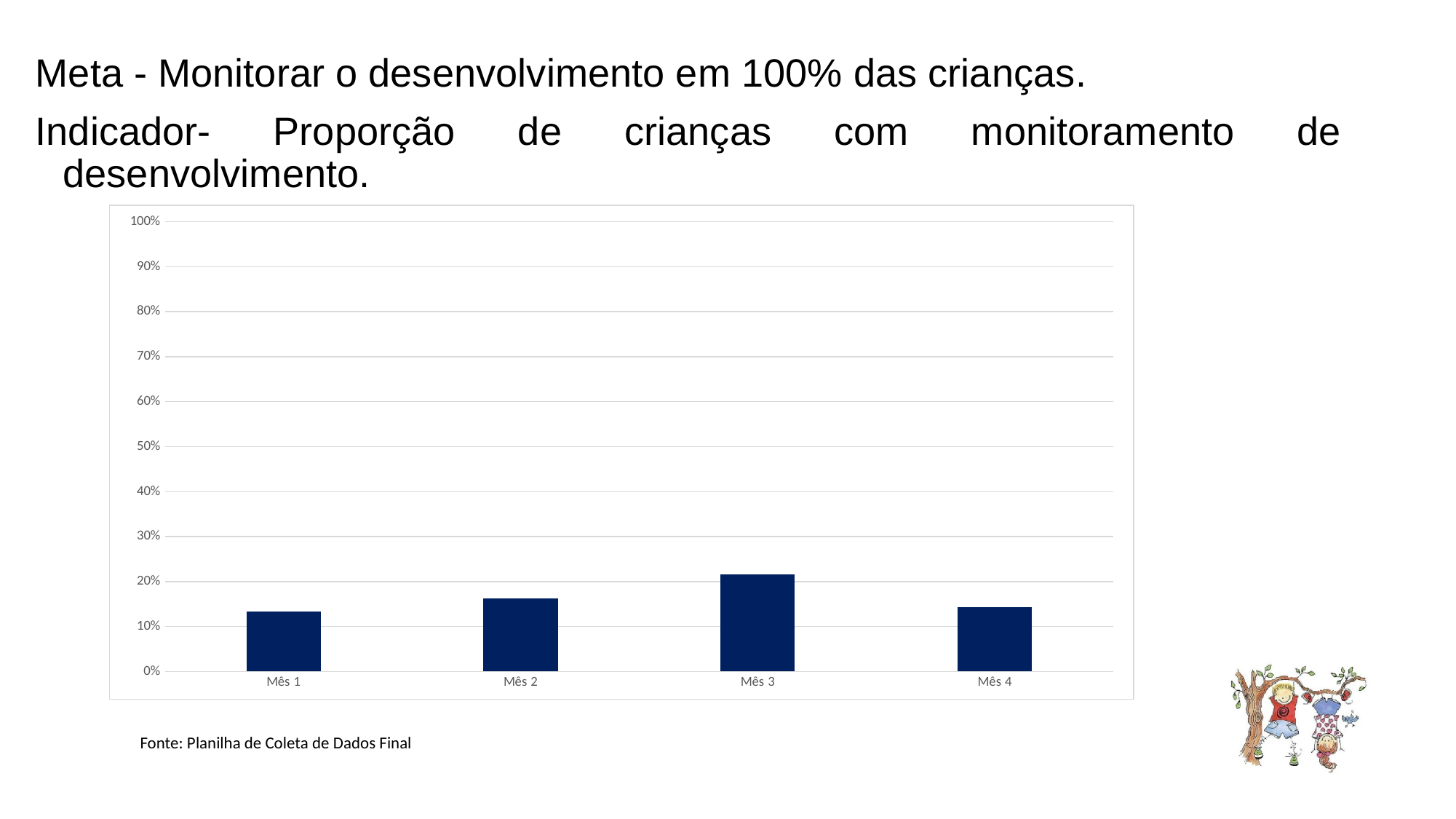
What kind of chart is shown on the slide? bar chart How many months (categories) are plotted on the x axis? 4 Which is larger, the value for Mês 3 or the value for Mês 4? Mês 3 Is the value for Mês 3 greater or less than 30%? less Do the values rise or fall from Mês 3 to Mês 4? fall Is the value for Mês 4 greater or less than 50%? less Is the value for Mês 1 greater or less than 10%? greater Do the values rise or fall from Mês 1 to Mês 3? rise Which is larger, the value for Mês 2 or the value for Mês 1? Mês 2 Which month has the highest proportion of children with development monitoring? Mês 3 What source is cited below the chart? Planilha de Coleta de Dados Final